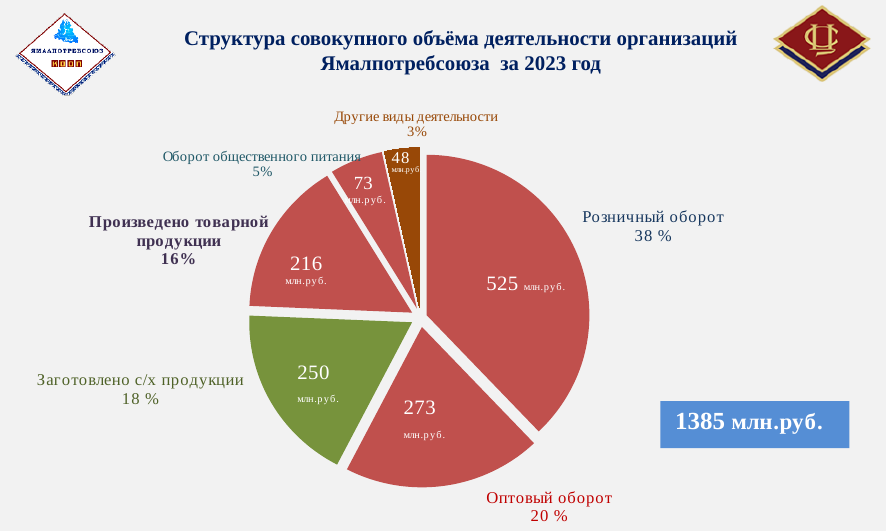
Which category has the smallest slice? Другие виды деятельности What type of chart is shown on the slide? pie chart What is the difference between the values for Розничный оборот and Оптовый оборот? 252 млн.руб. What is the value for Оборот общественного питания? 73 млн.руб. Which category has the largest slice? Розничный оборот Which is larger, Заготовлено с/х продукции or Произведено товарной продукции? Заготовлено с/х продукции What share of the pie does Оптовый оборот represent? 20 % What total value is shown on the slide for all categories combined? 1385 млн.руб. How many slices does the pie chart have? 6 What is the value for Розничный оборот? 525 млн.руб. What is the value for Заготовлено с/х продукции? 250 млн.руб. What share of the pie does Другие виды деятельности represent? 3%